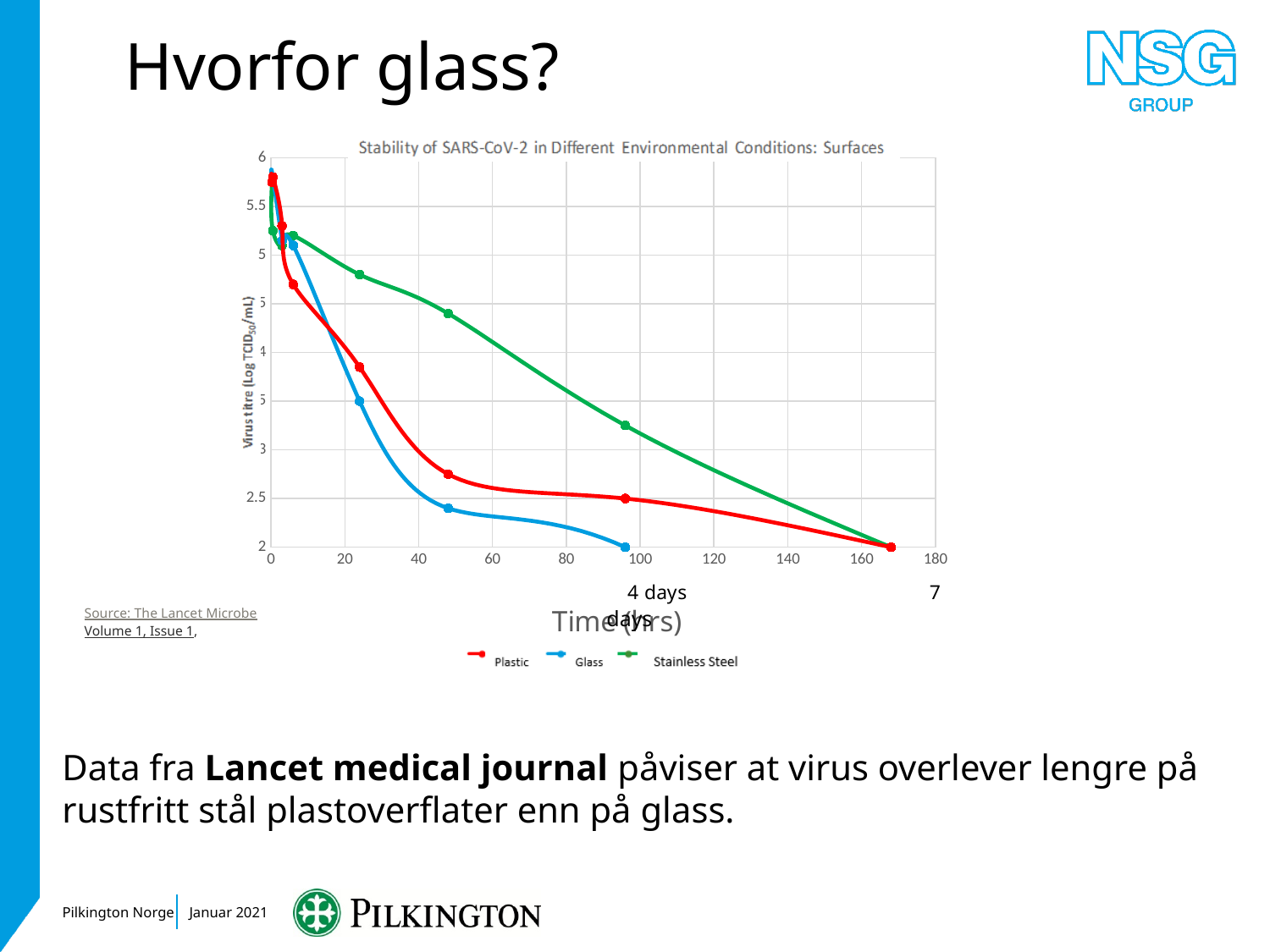
What is the title of the chart? Stability of SARS-CoV-2 in Different Environmental Conditions: Surfaces Which series has the lowest virus titre at 48 hours? Glass At 48 hours, which series has the higher virus titre, Stainless Steel or Glass? Stainless Steel Is the Glass value at 24 hours greater or less than 4? less Is the Glass value at 48 hours greater or less than 3? less Do the virus titre values rise or fall as time increases along the x axis? fall Is the Stainless Steel value at 48 hours greater or less than 4? greater At 96 hours, which series has the higher virus titre, Stainless Steel or Plastic? Stainless Steel What kind of chart is shown on the slide? line chart Which series are listed in the chart legend? Plastic, Glass, Stainless Steel How many series does the chart legend list? 3